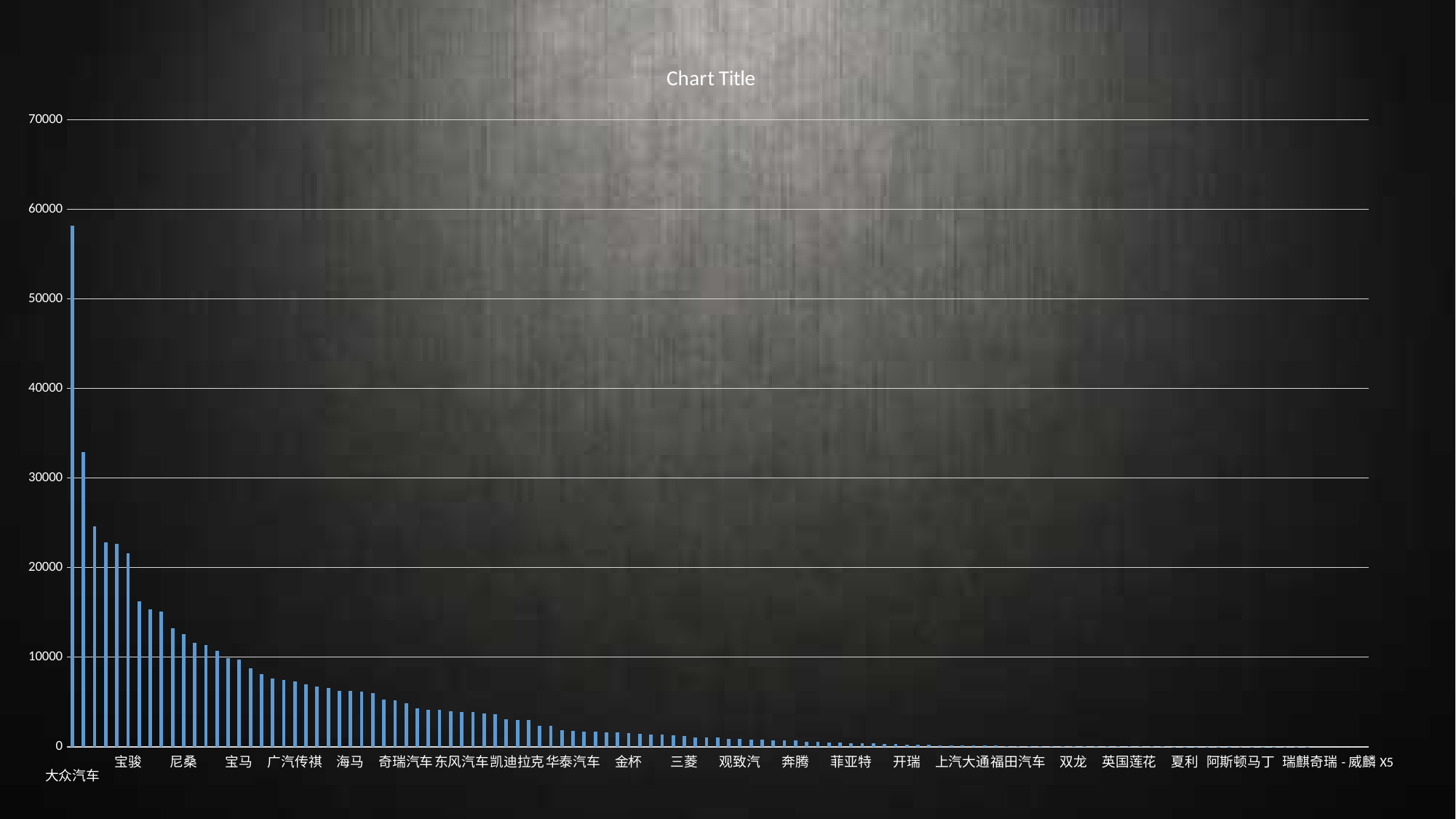
Which has the larger value, 大众汽车 or 尼桑? 大众汽车 Is the value for 尼桑 greater or less than 20000? less What kind of chart is shown on the slide? bar chart Is the value for 金杯 greater or less than 10000? less Do the values generally rise or fall from left to right along the x axis? fall Is the value for 大众汽车 greater or less than 50000? greater What is the title of the chart? Chart Title What is the highest value shown on the vertical axis? 70000 Which category has the highest value in the chart? 大众汽车